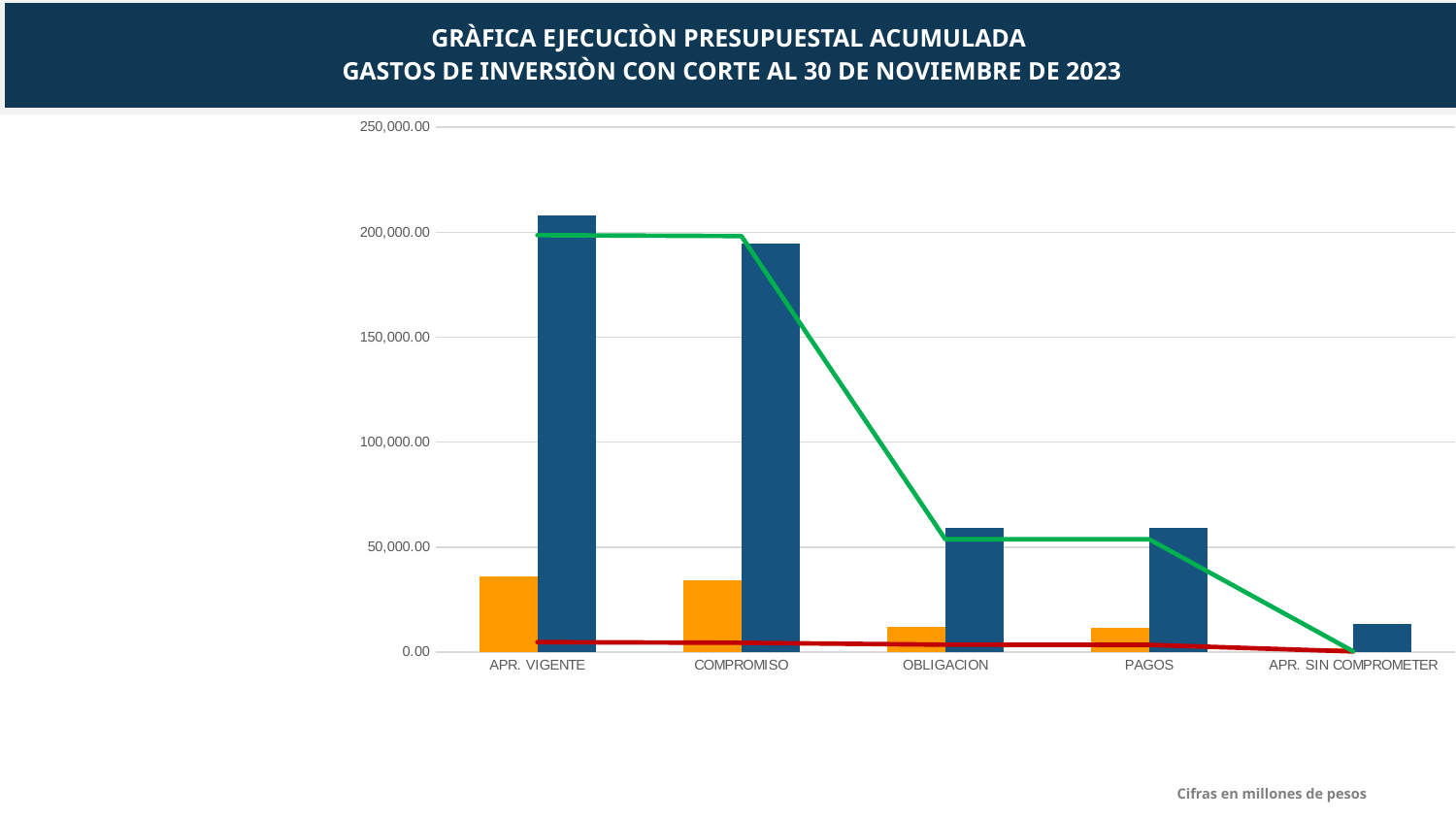
What kind of chart is shown on the slide? Bar chart with line series Which category has the tallest dark blue bar? APR. VIGENTE Which category has the shortest dark blue bar? APR. SIN COMPROMETER Is the orange bar for APR. VIGENTE greater or less than 50,000.00? less Which has the larger dark blue bar, APR. VIGENTE or COMPROMISO? APR. VIGENTE How many categories are shown on the x axis of the chart? 5 Is the dark blue bar for COMPROMISO greater or less than 200,000.00? less In what units are the figures in the chart expressed, according to the note on the slide? Millones de pesos Is the dark blue bar for APR. SIN COMPROMETER greater or less than 50,000.00? less Does the green line rise or fall from APR. VIGENTE to APR. SIN COMPROMETER? fall